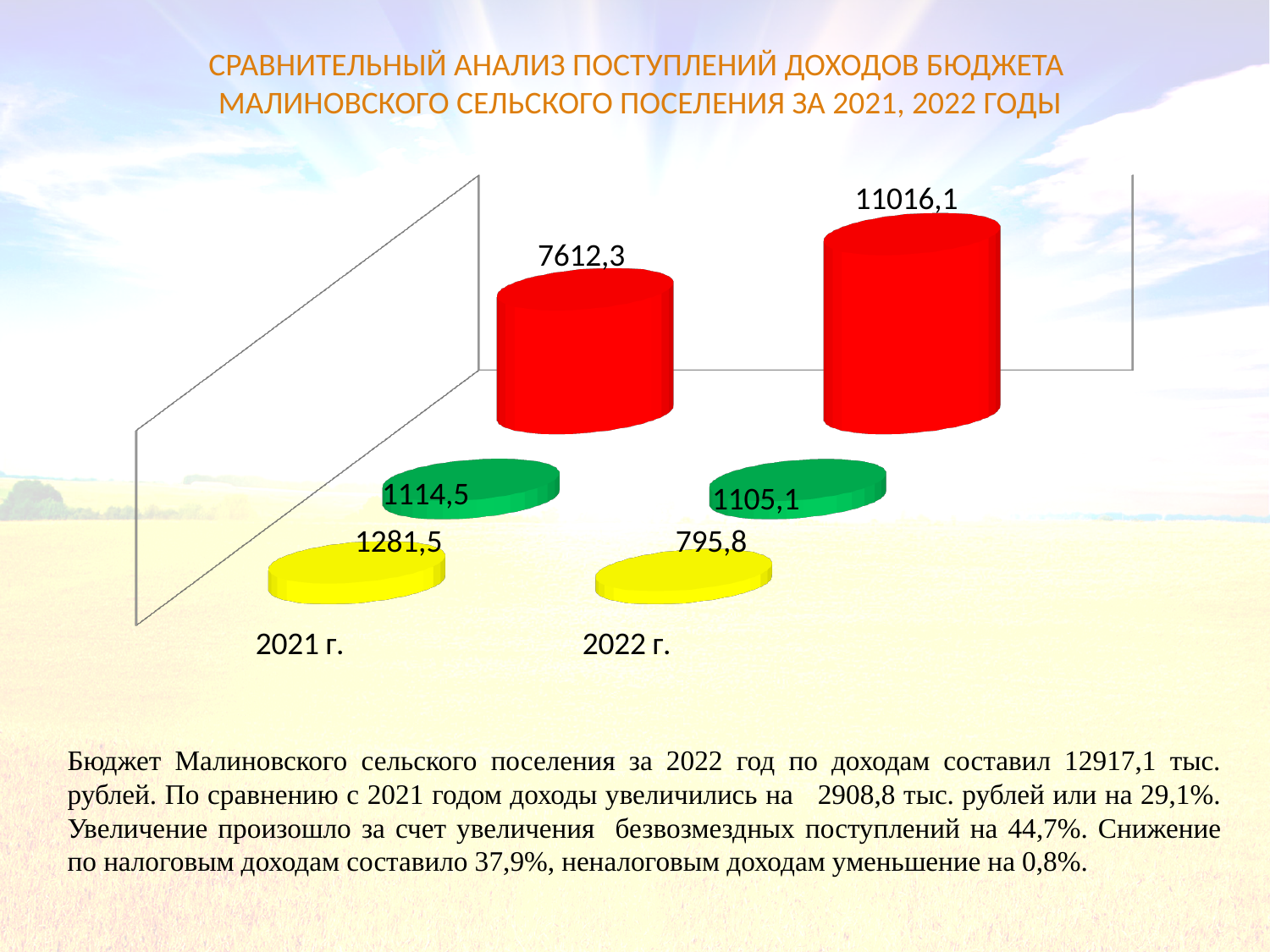
What is the value of the green bar for 2021 г.? 1114,5 By how much does the red bar for 2022 г. exceed the red bar for 2021 г.? 3403,8 Which year has the larger green bar value, 2021 г. or 2022 г.? 2021 г. What is the value of the green bar for 2022 г.? 1105,1 What is the value of the red bar for 2022 г.? 11016,1 What is the value of the yellow bar for 2022 г.? 795,8 What is the value of the red bar for 2021 г.? 7612,3 What kind of chart is shown on the slide? bar chart How many categories (years) are shown on the x axis of the chart? 2 Does the red series rise or fall from 2021 г. to 2022 г.? rises What is the difference between the yellow bar values for 2021 г. and 2022 г.? 485,7 What is the value of the yellow bar for 2021 г.? 1281,5